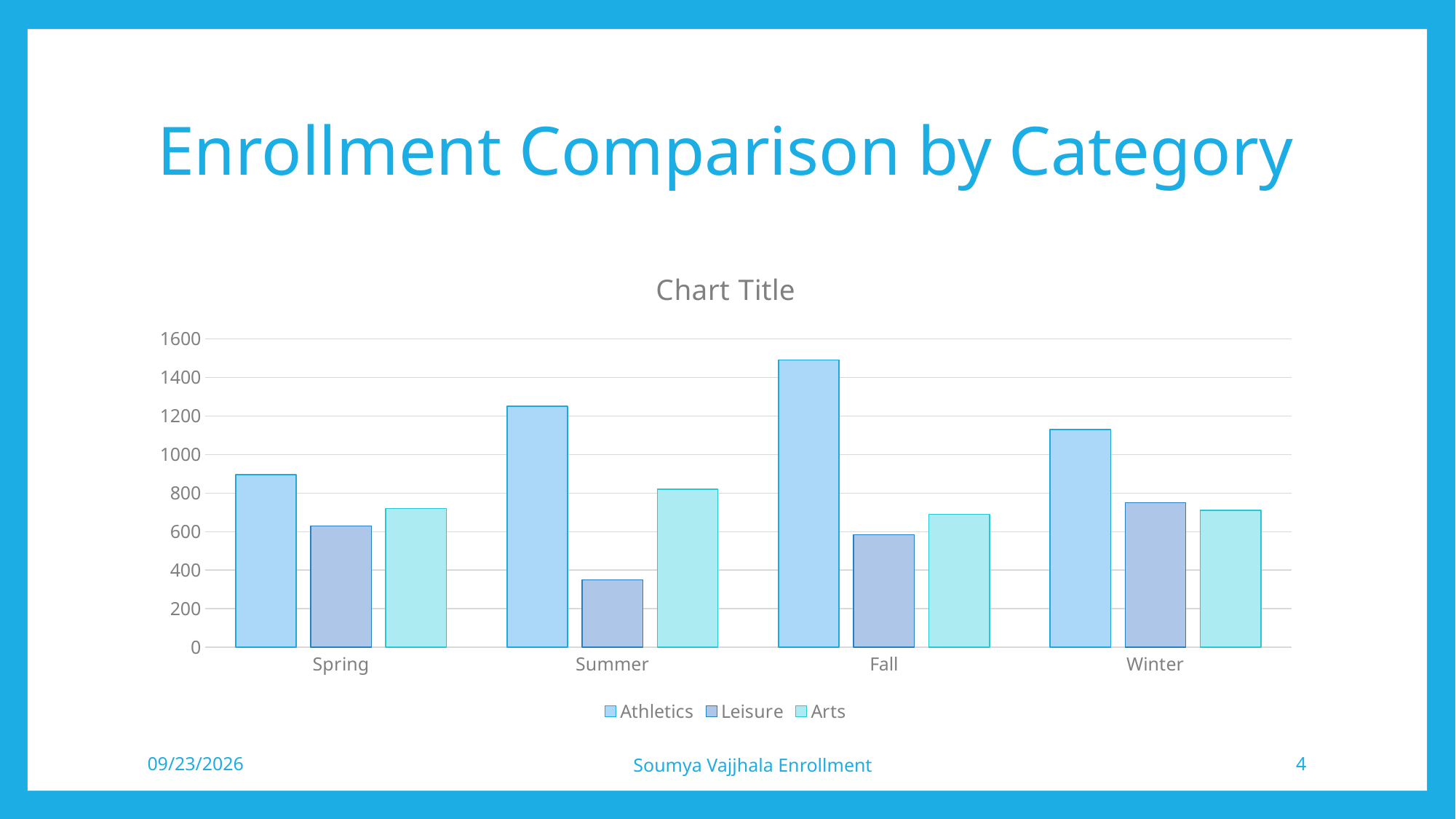
Is the Athletics value for Fall greater or less than 1400? greater Does the Athletics value rise or fall from Spring to Summer? Rise Is the Leisure value for Summer greater or less than 400? less What kind of chart is shown on the slide? Bar chart How many series does the chart's legend list? 3 In which season is the Leisure value lowest? Summer What are the three series listed in the chart's legend? Athletics, Leisure, Arts In which season is the Athletics value highest? Fall How many categories are shown on the x axis of the chart? 4 Is the Athletics value for Winter greater or less than 1000? greater For Spring, which is larger: the Athletics value or the Arts value? Athletics Which is larger: the Arts value for Summer or the Arts value for Fall? Summer